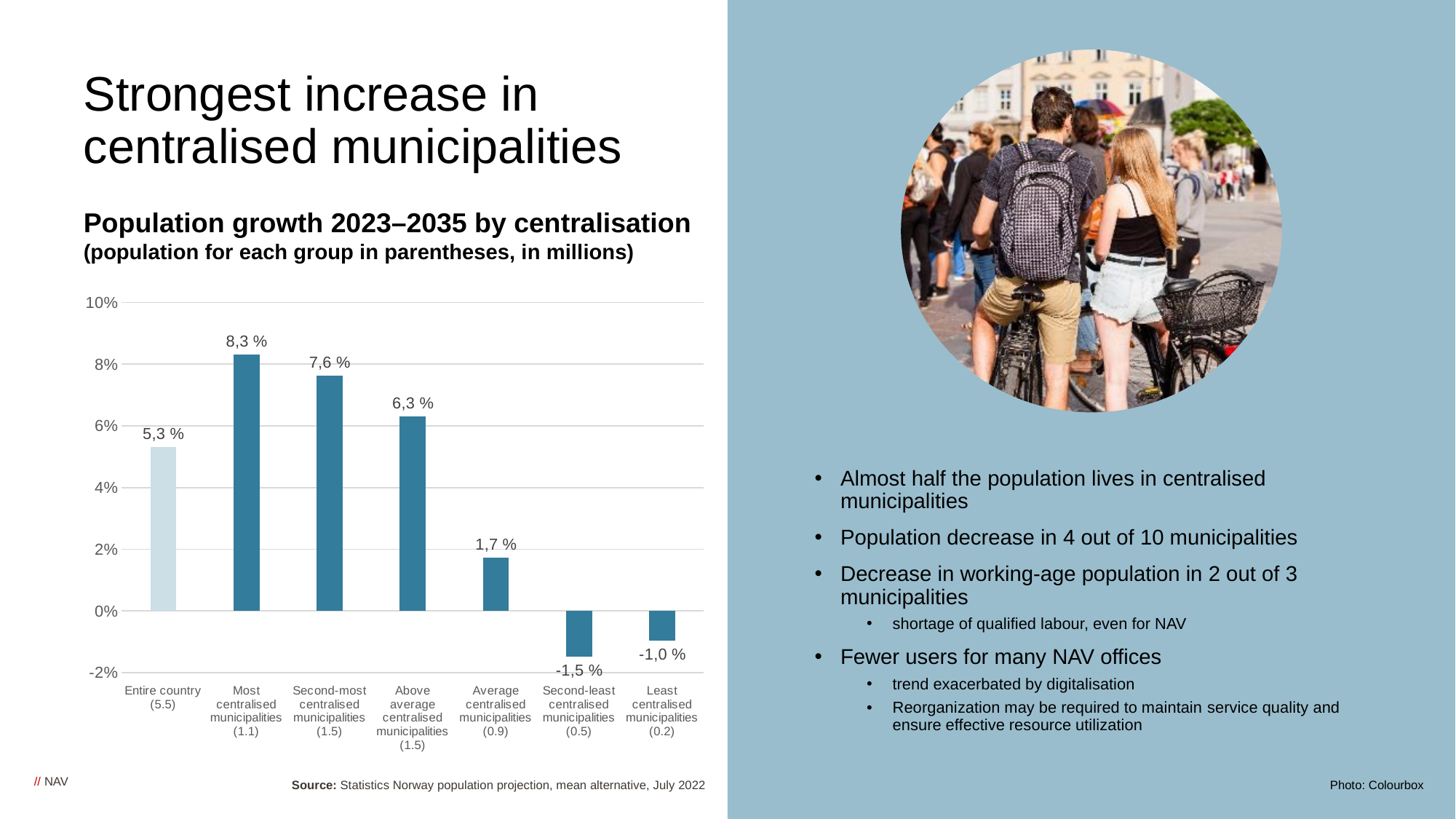
What kind of chart is shown on the slide? Bar chart Which is larger, the value for Above average centralised municipalities or the value for Average centralised municipalities? Above average centralised municipalities What is the population growth value for the Entire country? 5,3 % Is the value for Second-most centralised municipalities greater or less than 6%? greater What is the population growth value for Most centralised municipalities? 8,3 % How many categories are shown on the x axis of the chart? 7 What is the difference between the values for Most centralised municipalities and Second-most centralised municipalities? 0,7 % What is the title of the chart? Population growth 2023–2035 by centralisation Which category has the lowest population growth? Second-least centralised municipalities What is the population growth value for Second-least centralised municipalities? -1,5 % Do the values generally rise or fall from Most centralised municipalities to Least centralised municipalities along the x axis? Fall Which category has the highest population growth? Most centralised municipalities